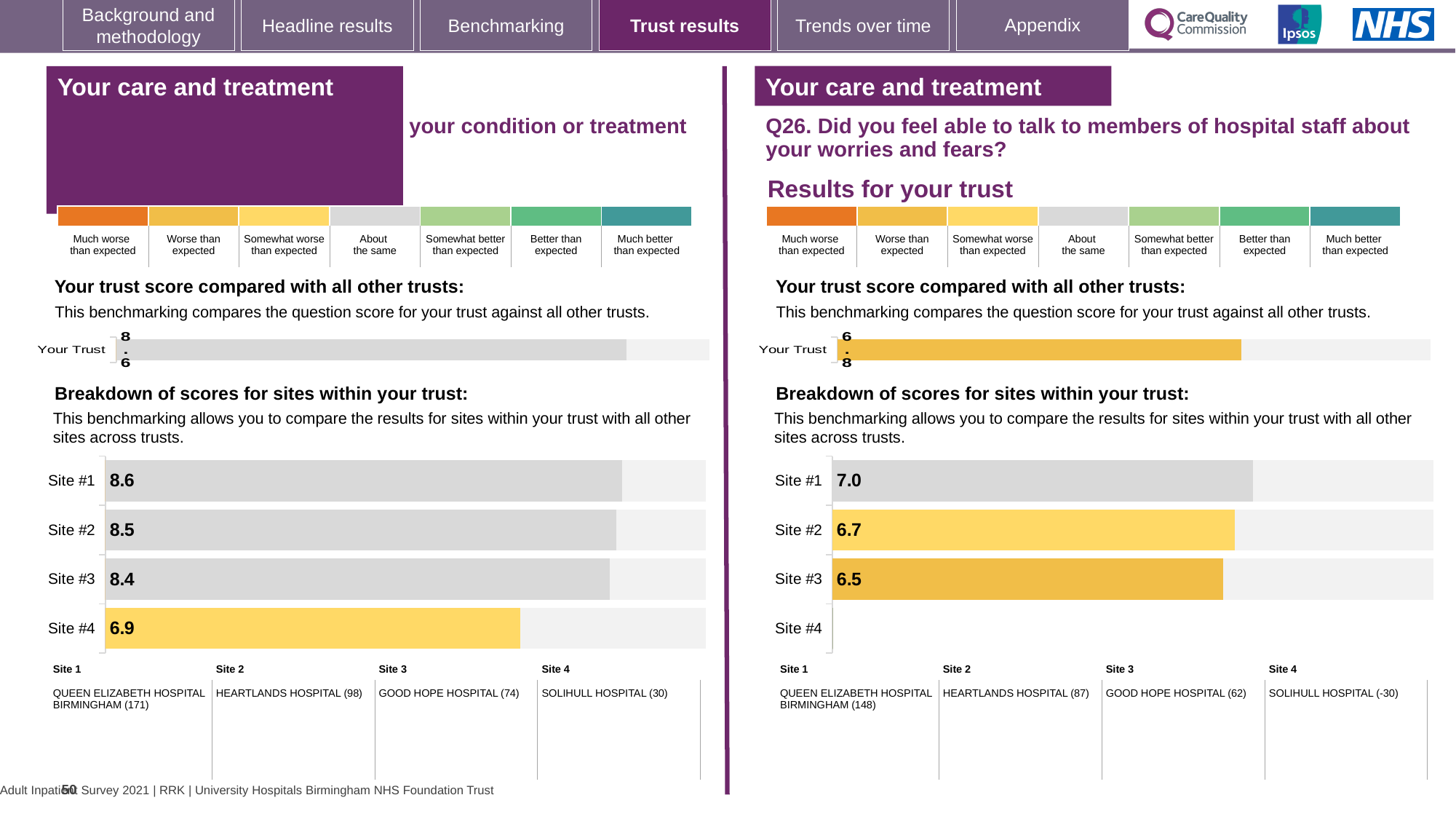
Which is larger: the Site #2 score in the left-hand chart or the Site #2 score in the right-hand (Q26) chart? Left-hand chart (8.5) In the right-hand (Q26) site breakdown chart, what is the difference between the scores for Site #1 and Site #3? 0.5 What type of chart is used for the site breakdown of scores on this slide? Bar chart In the left-hand site breakdown chart, what is the difference between the scores for Site #1 and Site #4? 1.7 In the right-hand (Q26) site breakdown chart, which site has the highest score? Site #1 In the right-hand (Q26) site breakdown chart, what is the score for Site #3? 6.5 In the left-hand 'Your trust score compared with all other trusts' chart, what is the score for Your Trust? 8.6 In the right-hand (Q26) site breakdown chart, what is the score for Site #2? 6.7 In the left-hand site breakdown chart, what is the score for Site #1? 8.6 In the left-hand site breakdown chart, what is the score for Site #4? 6.9 In the right-hand (Q26) 'Your trust score compared with all other trusts' chart, what is the score for Your Trust? 6.8 In the left-hand site breakdown chart, which site has the lowest score? Site #4